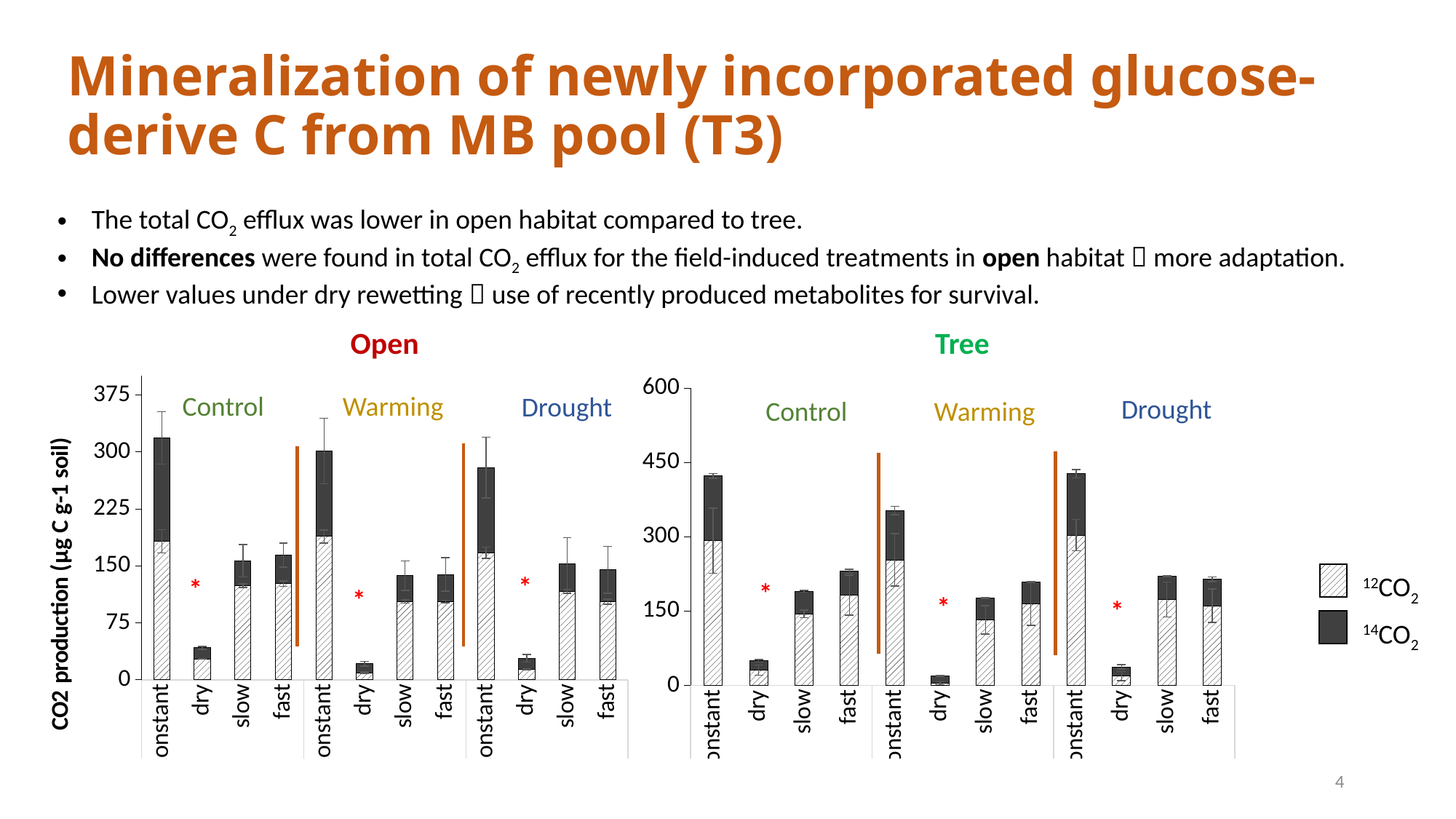
In the Tree chart, which bar has the lowest total value? Warming dry What are the three treatment groups labelled on the Open chart? Control, Warming, Drought What type of chart is the Open chart? stacked bar chart In the Tree chart, is the total value for the Warming constant bar greater or less than 300? greater What are the two series named in the legend? 12CO2 and 14CO2 How many series does the legend list? 2 In the Tree chart, is the total value for the Warming dry bar greater or less than 150? less In the Open chart, which bar has the larger total value: Control constant or Drought constant? Control constant How many bars are plotted in the Tree chart? 12 In the Tree chart, is the total value for the Control constant bar greater or less than 450? less